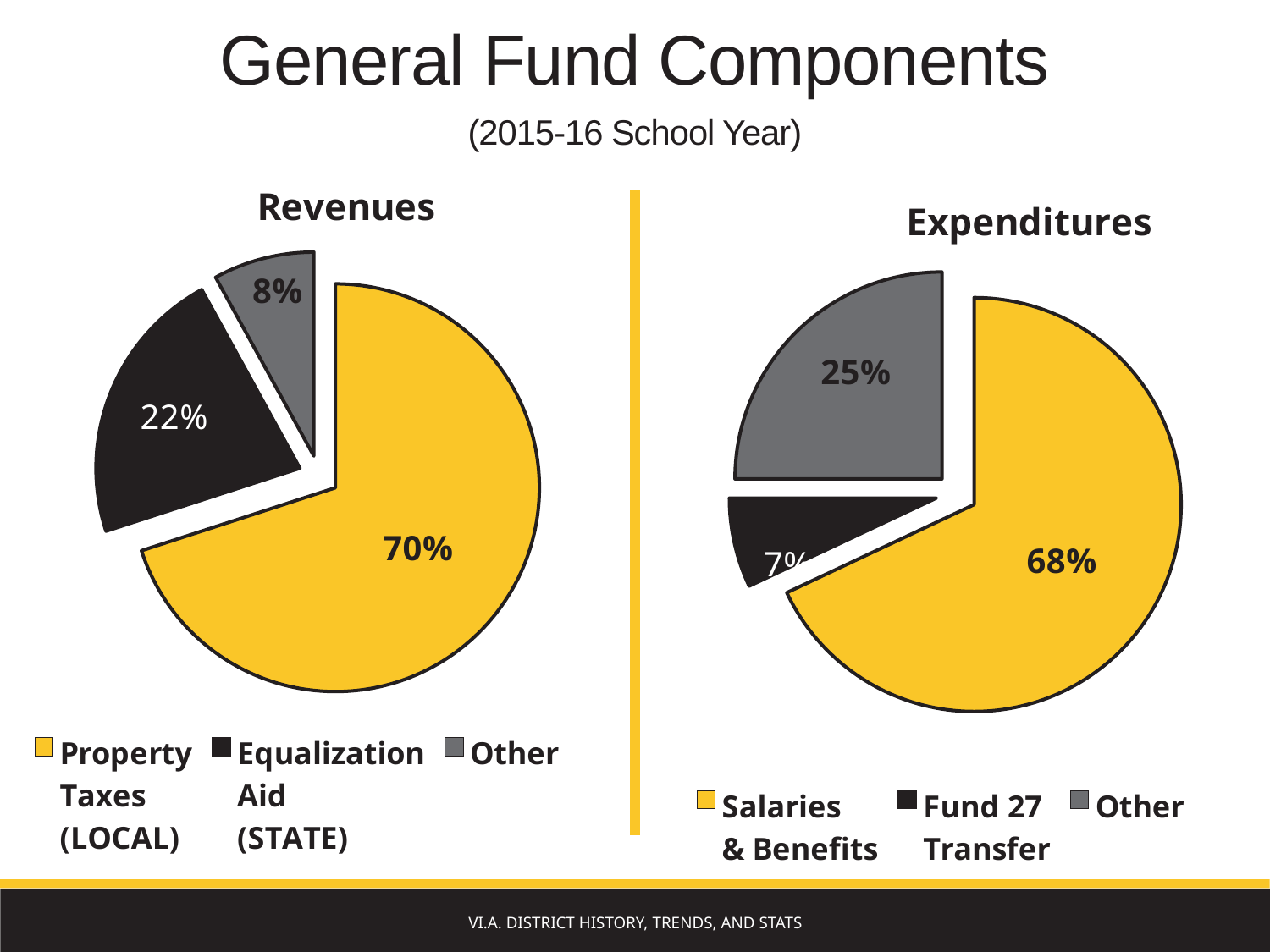
In the Revenues chart, what share of revenues comes from Property Taxes (LOCAL)? 70% How many categories does the legend of the Expenditures chart list? 3 In the Revenues chart, what percentage is Equalization Aid (STATE)? 22% What kind of chart is the Revenues chart? Pie chart In the Expenditures chart, what percentage is labelled Other? 25% In the Expenditures chart, what is the difference between Salaries & Benefits and Other? 43% In the Revenues chart, which category is the largest? Property Taxes (LOCAL) In the Expenditures chart, which category is the smallest? Fund 27 Transfer In the Expenditures chart, what share of expenditures is Salaries & Benefits? 68% In the Revenues chart, what is the difference between Property Taxes (LOCAL) and Equalization Aid (STATE)? 48% In the Revenues chart, which category is the smallest? Other In the Revenues chart, what percentage is labelled Other? 8%